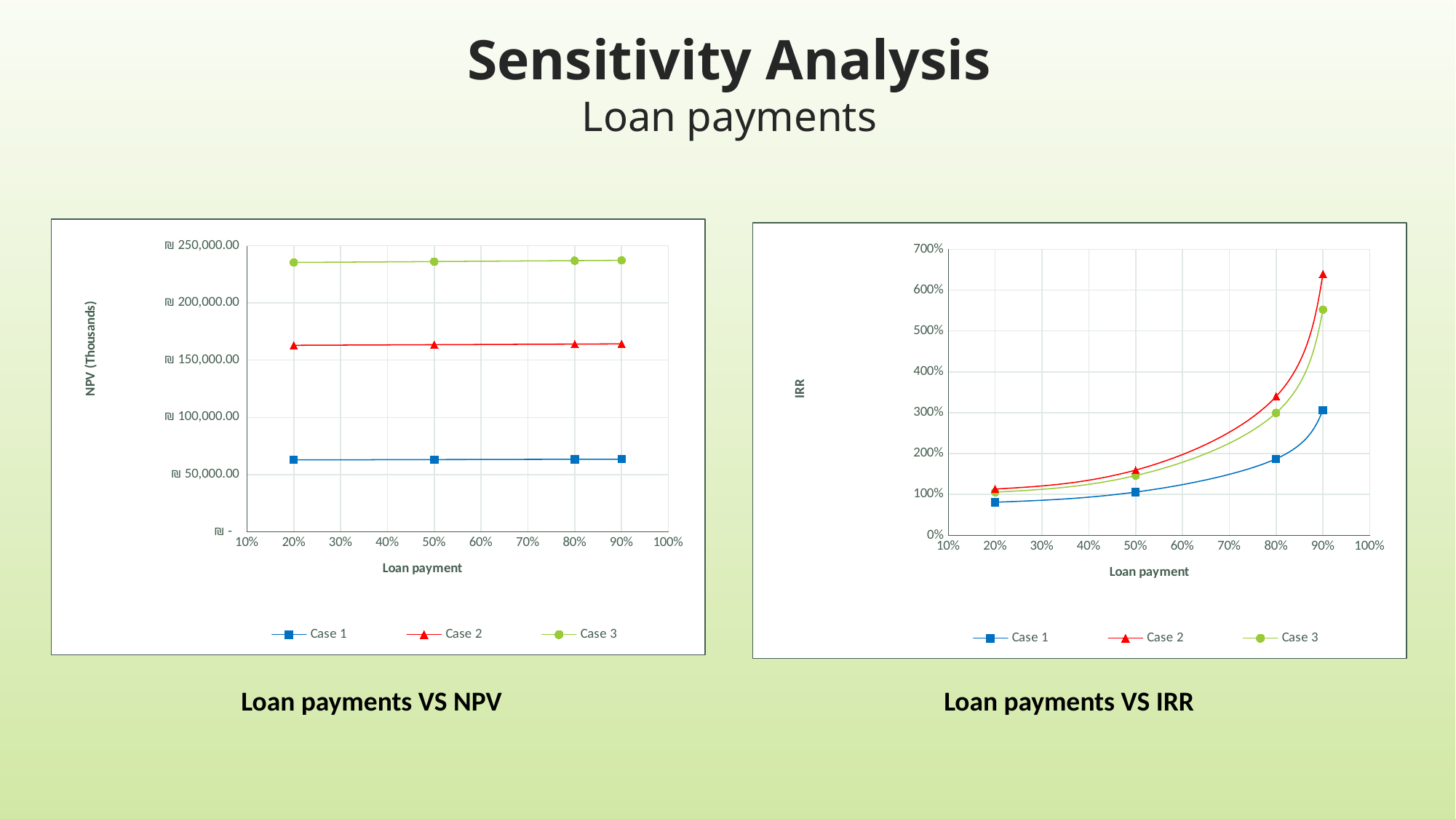
In the 'Loan payments VS NPV' chart, is the NPV for Case 3 at a 20% loan payment greater or less than ₪ 200,000.00? greater In the 'Loan payments VS IRR' chart, is the IRR for Case 2 at a 90% loan payment greater or less than 600%? greater In the 'Loan payments VS NPV' chart, which case has the lowest NPV? Case 1 In the 'Loan payments VS IRR' chart, is the IRR for Case 1 at a 20% loan payment greater or less than 100%? less In the 'Loan payments VS NPV' chart, how many data points are plotted for Case 1? 4 In the 'Loan payments VS IRR' chart, which case has the highest IRR at a 90% loan payment? Case 2 In the 'Loan payments VS IRR' chart, how do the IRR values change as the loan payment increases from 20% to 90%? They rise What is the x-axis title of the 'Loan payments VS IRR' chart? Loan payment In the 'Loan payments VS NPV' chart, which case has the highest NPV? Case 3 How many series does the legend of the 'Loan payments VS IRR' chart list? 3 What kind of chart is the 'Loan payments VS NPV' chart? line chart